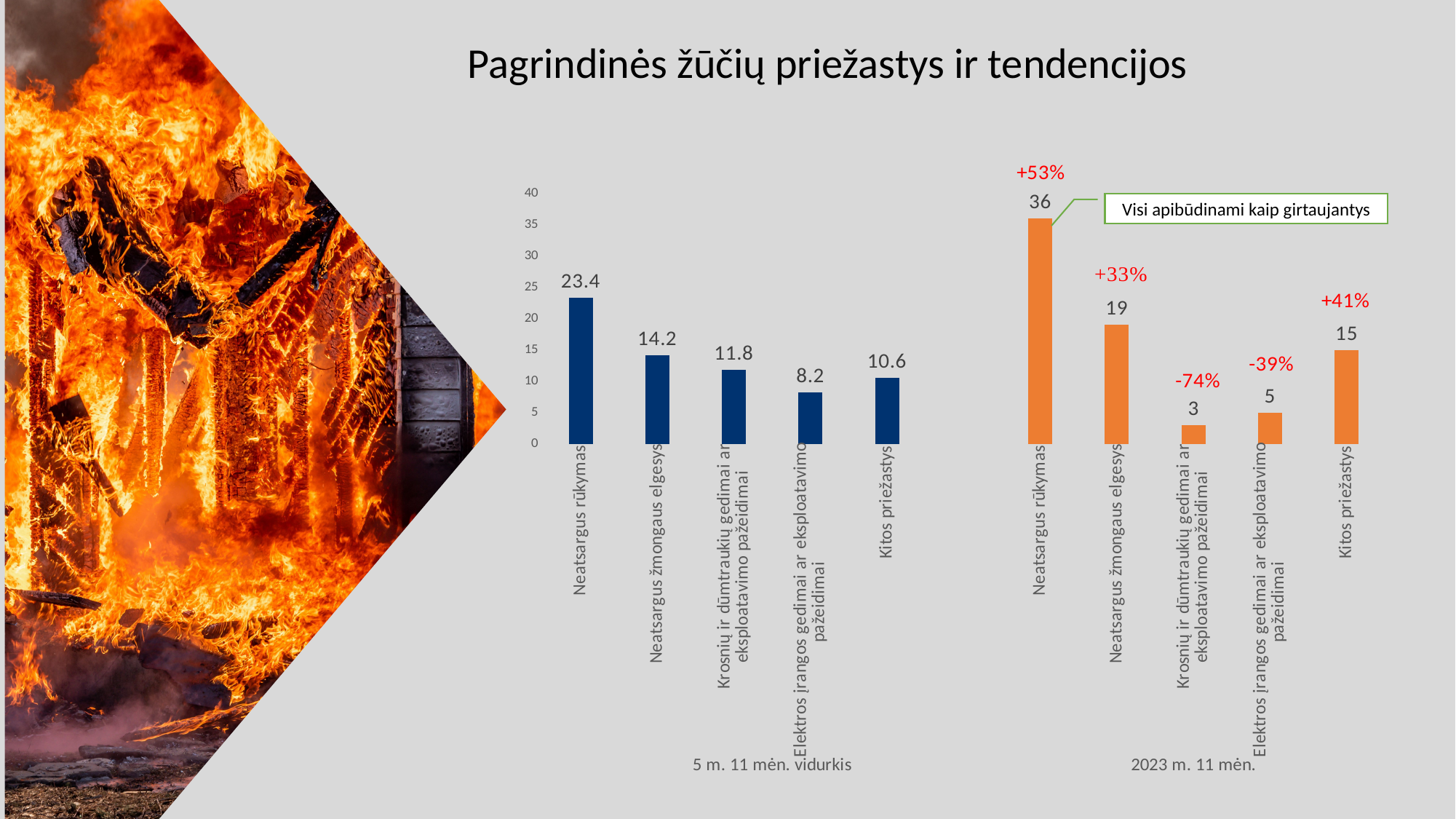
What is the value for Neatsargus rūkymas in the 5 m. 11 mėn. vidurkis group? 23.4 What is the value for Elektros įrangos gedimai ar eksploatavimo pažeidimai in the 5 m. 11 mėn. vidurkis group? 8.2 What type of chart is shown on the slide? Bar chart What is the title of the chart on the slide? Pagrindinės žūčių priežastys ir tendencijos Which category has the highest value in the 5 m. 11 mėn. vidurkis group? Neatsargus rūkymas Which category has the lowest value in the 2023 m. 11 mėn. group? Krosnių ir dūmtraukių gedimai ar eksploatavimo pažeidimai What percentage change is shown above the Krosnių ir dūmtraukių gedimai ar eksploatavimo pažeidimai bar in the 2023 m. 11 mėn. group? -74% What is the value for Kitos priežastys in the 2023 m. 11 mėn. group? 15 What is the difference between the 2023 m. 11 mėn. value and the 5 m. 11 mėn. vidurkis value for Neatsargus žmongaus elgesys? 4.8 Which is larger: the 2023 m. 11 mėn. value for Kitos priežastys or the 5 m. 11 mėn. vidurkis value for Kitos priežastys? 2023 m. 11 mėn. What is the value for Neatsargus rūkymas in the 2023 m. 11 mėn. group? 36 How many categories are shown in each group of the chart? 5